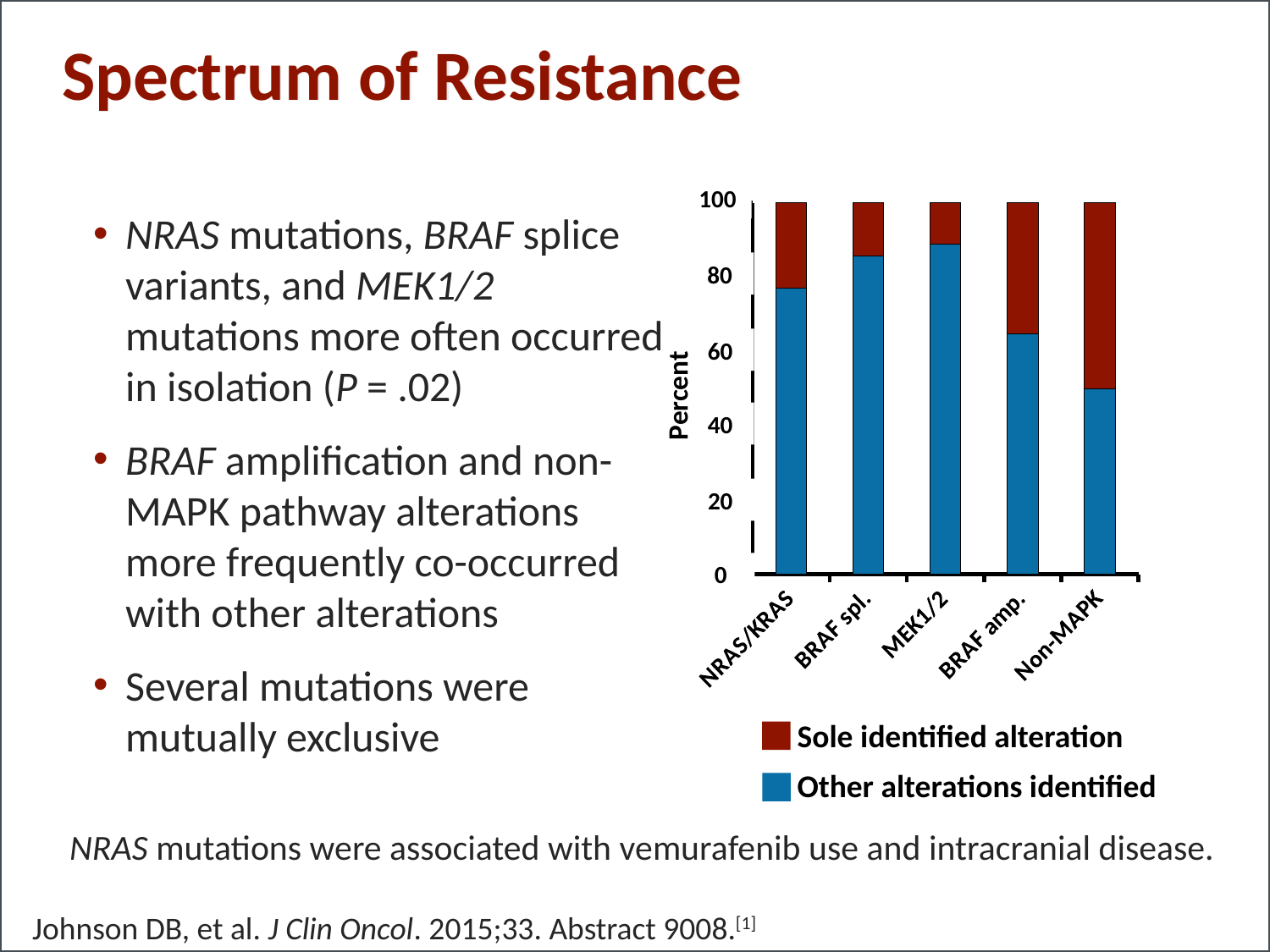
Is the 'Other alterations identified' value for Non-MAPK greater or less than 60? less What kind of chart is shown on the slide? Stacked bar chart How many categories are shown on the x axis of the chart? 5 Which category has the smallest 'Other alterations identified' portion? Non-MAPK Which has a larger 'Other alterations identified' portion, NRAS/KRAS or BRAF amp.? NRAS/KRAS Is the 'Other alterations identified' value for NRAS/KRAS greater or less than 60? greater Which category has the largest 'Sole identified alteration' portion? Non-MAPK Which legend entry is shown in dark red? Sole identified alteration How many series does the chart legend list? 2 Is the 'Other alterations identified' value for BRAF amp. greater or less than 80? less What is the label of the y axis of the chart? Percent